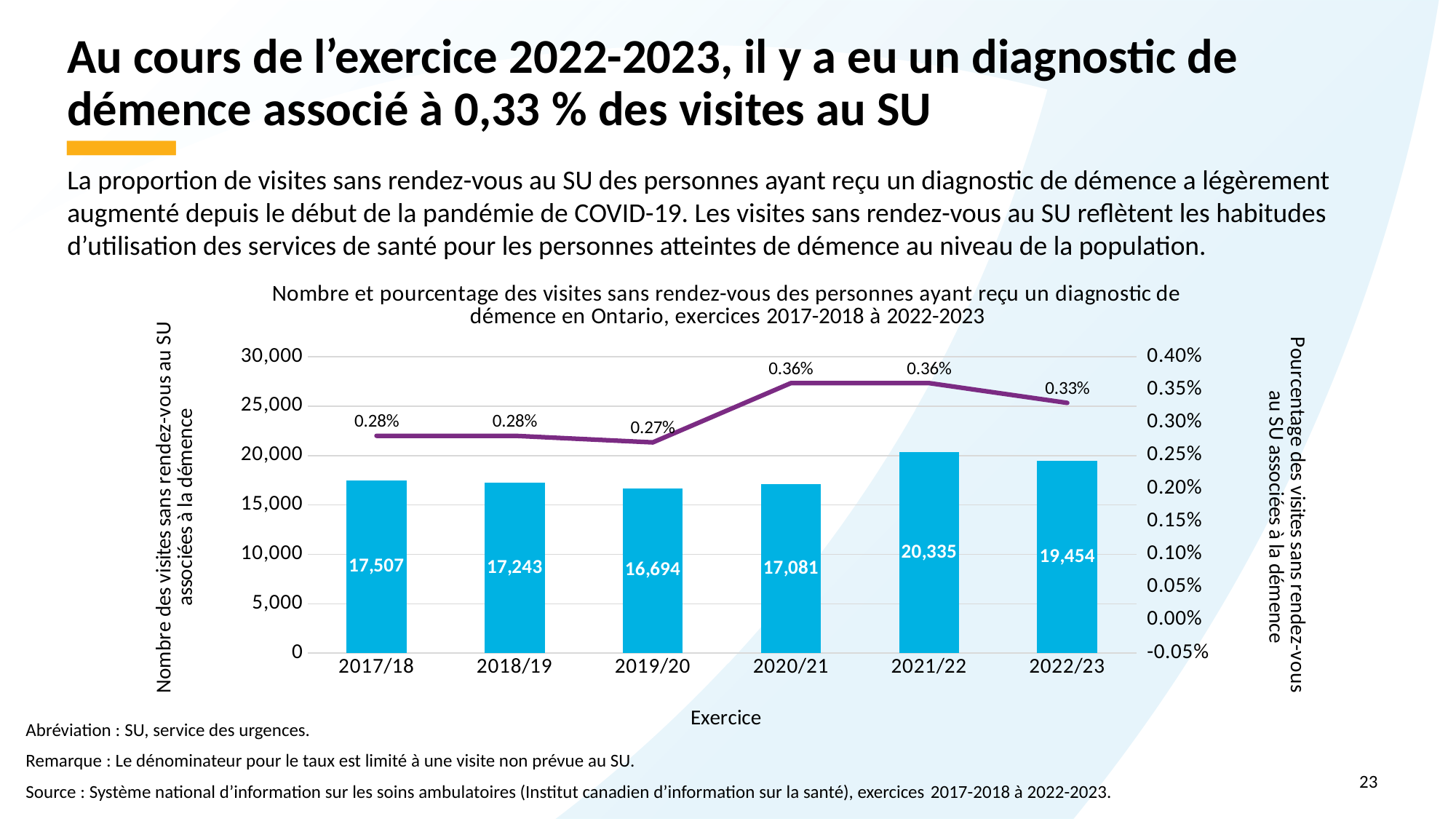
Is the number of visits in 2021/22 greater or less than 20,000? greater What is the difference in the number of visits between 2021/22 and 2022/23? 881 What kind of chart is used to show the number of visits? bar chart Which fiscal year has the lowest number of unscheduled ED visits associated with dementia? 2019/20 Which fiscal year has the highest number of unscheduled ED visits associated with dementia? 2021/22 What is the label of the x axis of the chart? Exercice What is the number of unscheduled ED visits associated with dementia in 2022/23? 19,454 What percentage of unscheduled ED visits were associated with dementia in 2017/18? 0.28% What is the number of unscheduled ED visits associated with dementia in 2019/20? 16,694 How many fiscal years are shown on the x axis of the chart? 6 What percentage of unscheduled ED visits were associated with dementia in 2020/21? 0.36% Which year has more unscheduled ED visits associated with dementia, 2017/18 or 2020/21? 2017/18